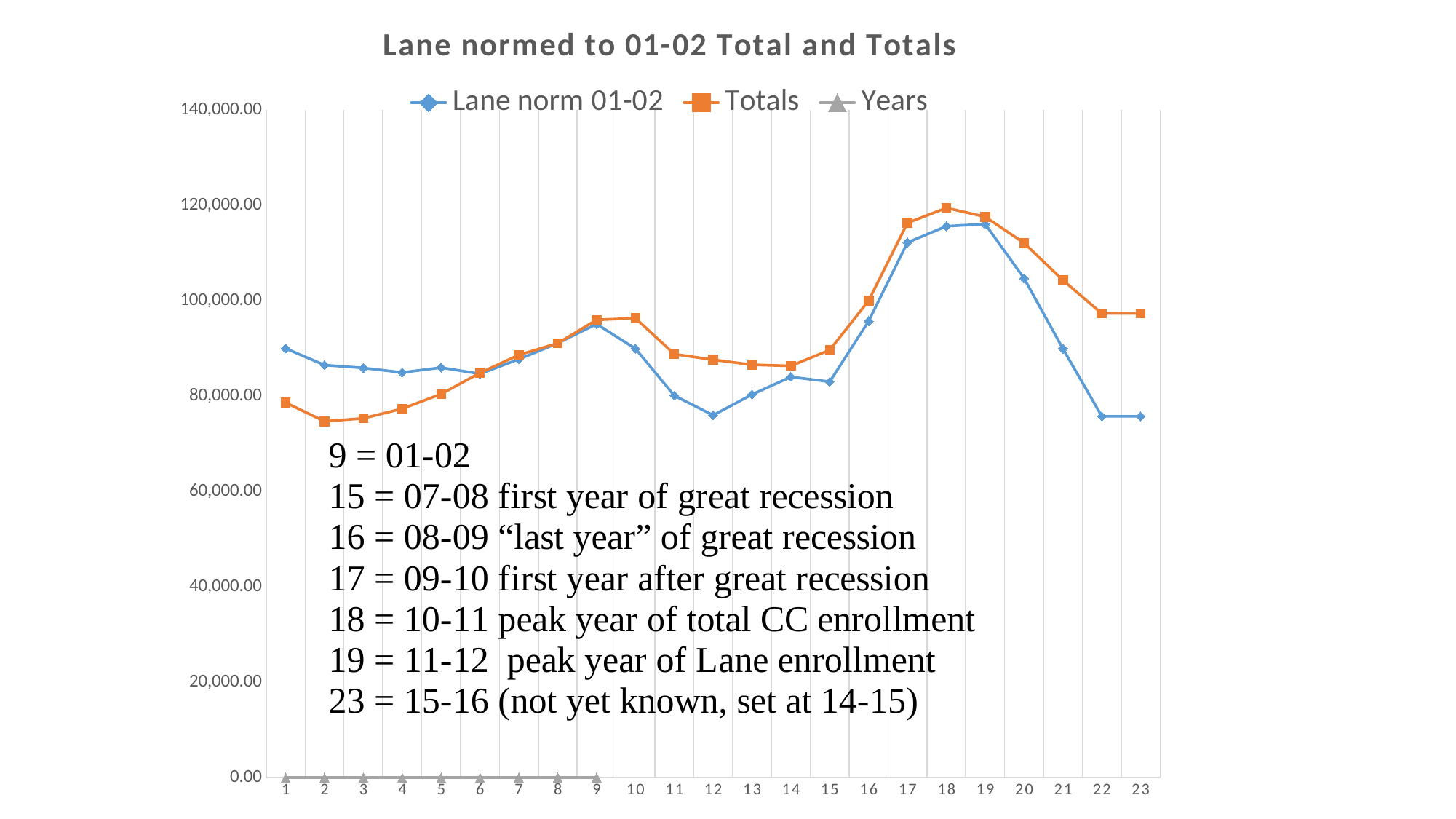
At point 18, which series has the larger value, Lane norm 01-02 or Totals? Totals At point 1, which series has the larger value, Lane norm 01-02 or Totals? Lane norm 01-02 Does the Lane norm 01-02 series rise or fall from point 19 to point 22? fall How many points are on the x axis of the chart? 23 What is the title of the chart? Lane normed to 01-02 Total and Totals Which series is drawn with orange square markers? Totals Is the Lane norm 01-02 value at point 12 greater or less than 80,000.00? less What type of chart is shown on the slide? line chart At which x-axis point does the Totals series reach its highest value? 18 Is the Totals value at point 22 greater or less than 100,000.00? less How many series does the legend list? 3 Is the Totals value at point 18 greater or less than 100,000.00? greater